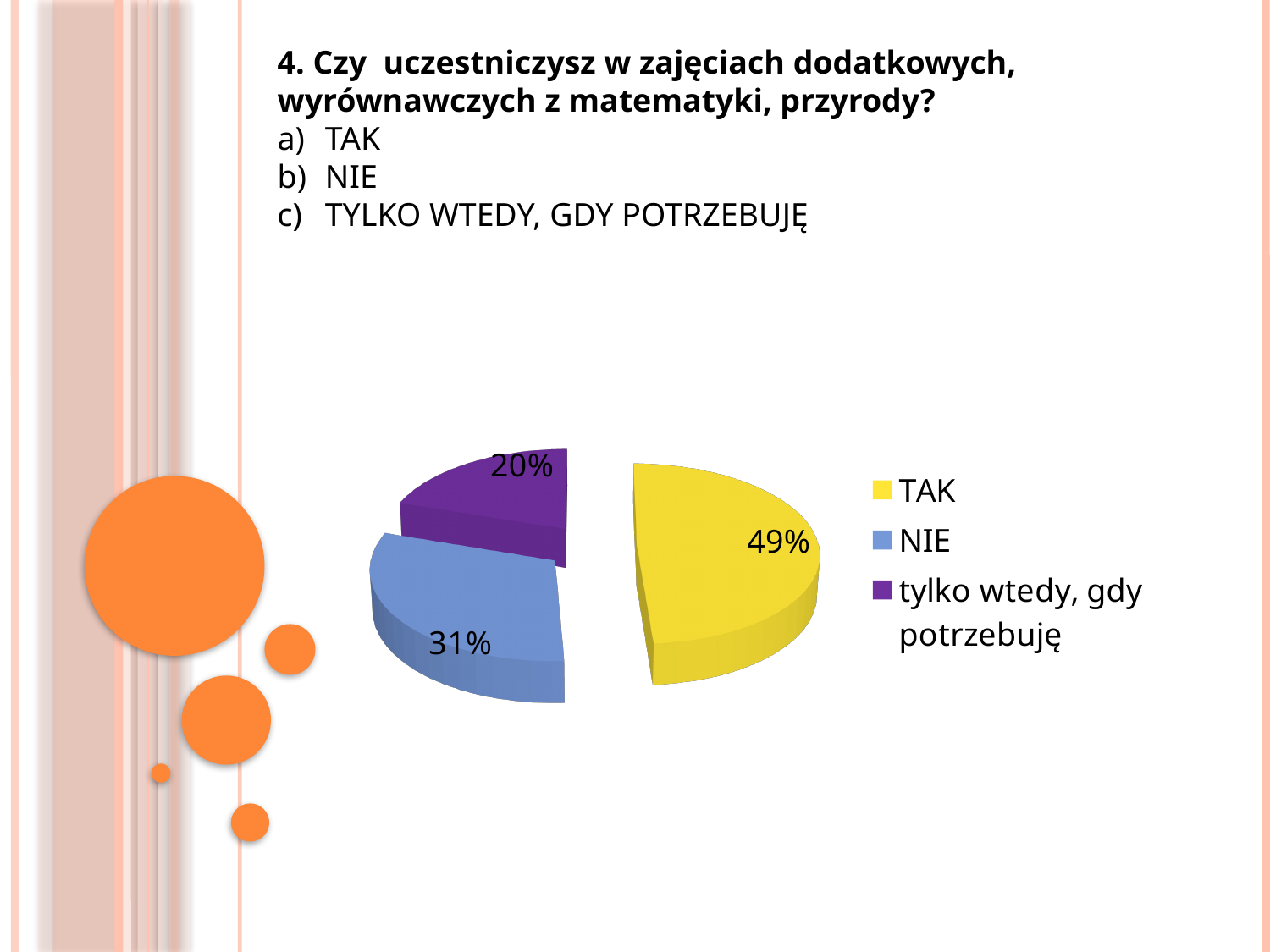
Which category has the smallest slice of the pie? tylko wtedy, gdy potrzebuję What colour is the slice for NIE? blue What kind of chart is shown on the slide? pie chart What colour is the slice for TAK? yellow How many slices does the pie chart have? 3 Which is larger, the slice for NIE or the slice for 'tylko wtedy, gdy potrzebuję'? NIE Which category has the largest slice of the pie? TAK What share of the pie does 'tylko wtedy, gdy potrzebuję' represent? 20% What share of the pie does NIE represent? 31% What share of the pie does TAK represent? 49% What is the difference in percentage points between NIE and 'tylko wtedy, gdy potrzebuję'? 11 What is the difference in percentage points between TAK and NIE? 18